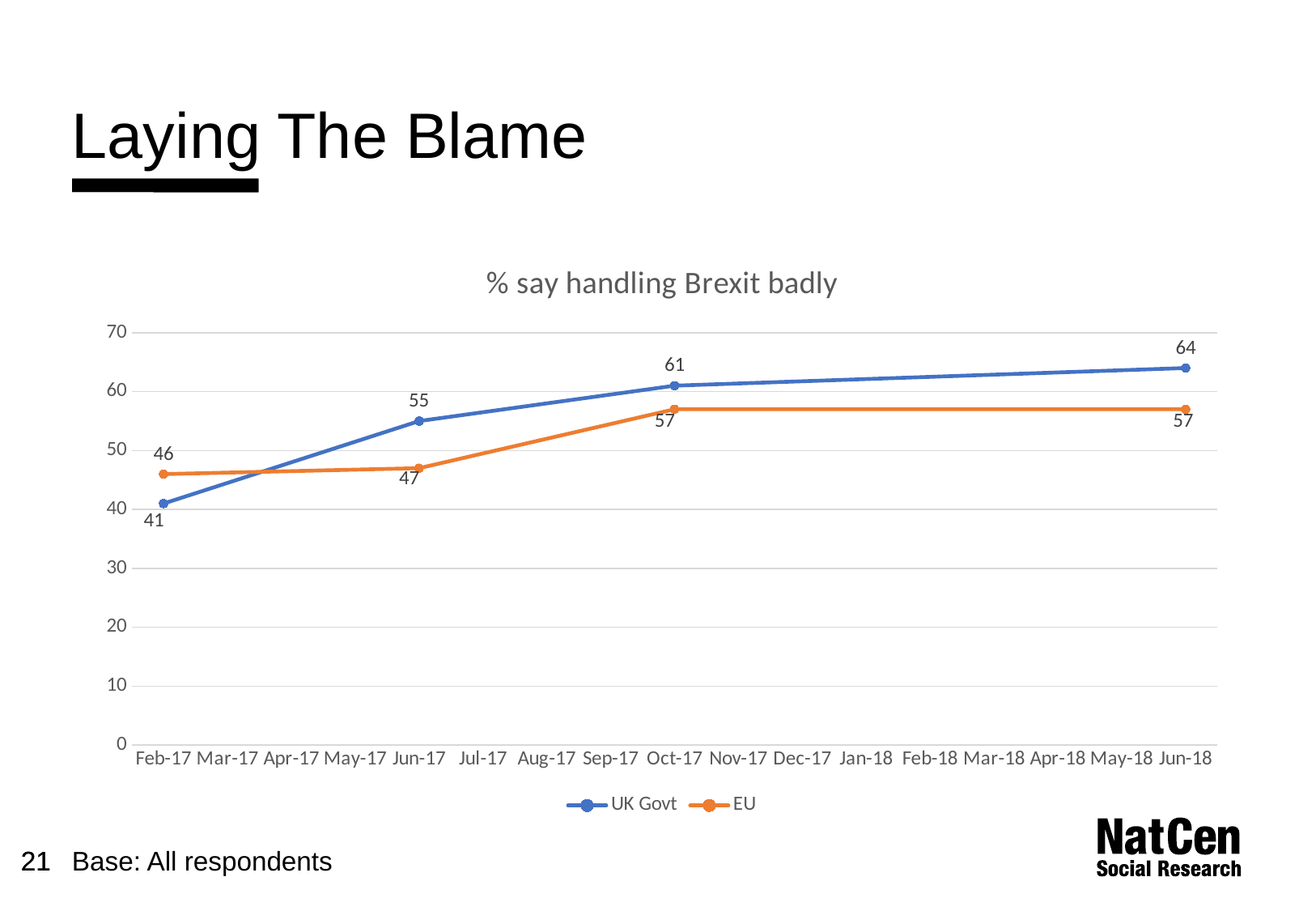
Which series has the larger value in Oct-17, UK Govt or EU? UK Govt What is the value for EU in Jun-17? 47 How many series does the legend list? 2 At which date is the EU series lowest? Feb-17 Does the UK Govt series rise or fall from Feb-17 to Jun-18? Rise What kind of chart is shown? Line chart What is the value for UK Govt in Feb-17? 41 Which series has the larger value in Feb-17, UK Govt or EU? EU At which date is the UK Govt series highest? Jun-18 What is the difference between UK Govt and EU in Jun-18? 7 What is the value for EU in Oct-17? 57 What is the value for UK Govt in Jun-18? 64